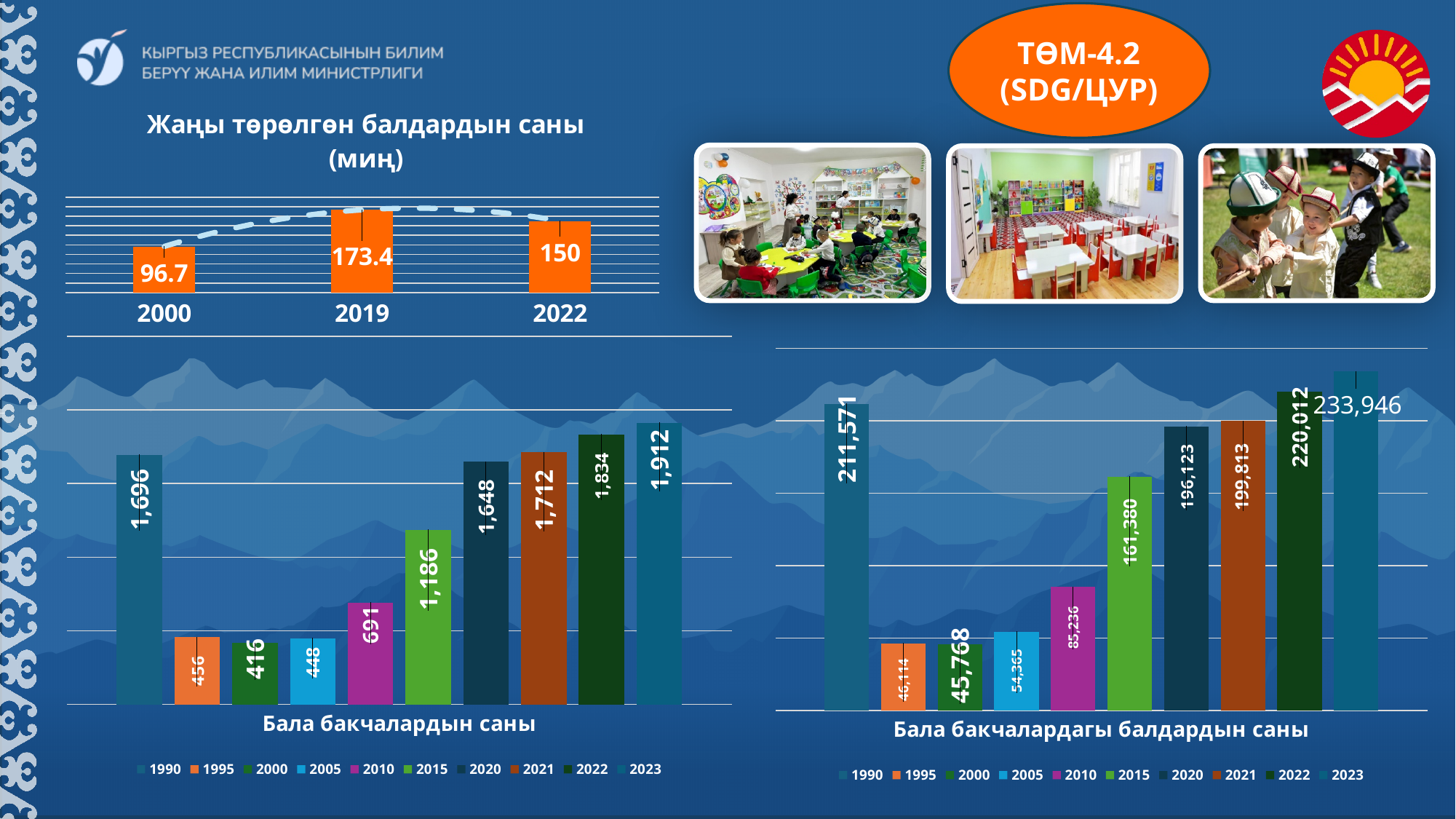
In the bottom-right chart 'Бала бакчалардагы балдардын саны', what is the value for 2020? 196,123 In the top-left chart 'Жаңы төрөлгөн балдардын саны (миң)', which year has the lowest value? 2000 In the bottom-right chart 'Бала бакчалардагы балдардын саны', which is larger, the value for 1990 or the value for 2022? 2022 What kind of chart is the bottom-right chart 'Бала бакчалардагы балдардын саны'? bar chart In the bottom-left chart 'Бала бакчалардын саны', what is the value for 2015? 1,186 In the bottom-left chart 'Бала бакчалардын саны', which year has the lowest value? 2000 In the top-left chart 'Жаңы төрөлгөн балдардын саны (миң)', what is the difference between the 2019 and 2022 values? 23.4 In the bottom-right chart 'Бала бакчалардагы балдардын саны', do the values rise or fall from 2005 to 2023? rise In the bottom-left chart 'Бала бакчалардын саны', what is the difference between the 2023 and 2022 values? 78 In the bottom-left chart 'Бала бакчалардын саны', how many bars are plotted? 10 In the top-left chart 'Жаңы төрөлгөн балдардын саны (миң)', what is the value for 2019? 173.4 In the bottom-left chart 'Бала бакчалардын саны', which year has the highest value? 2023